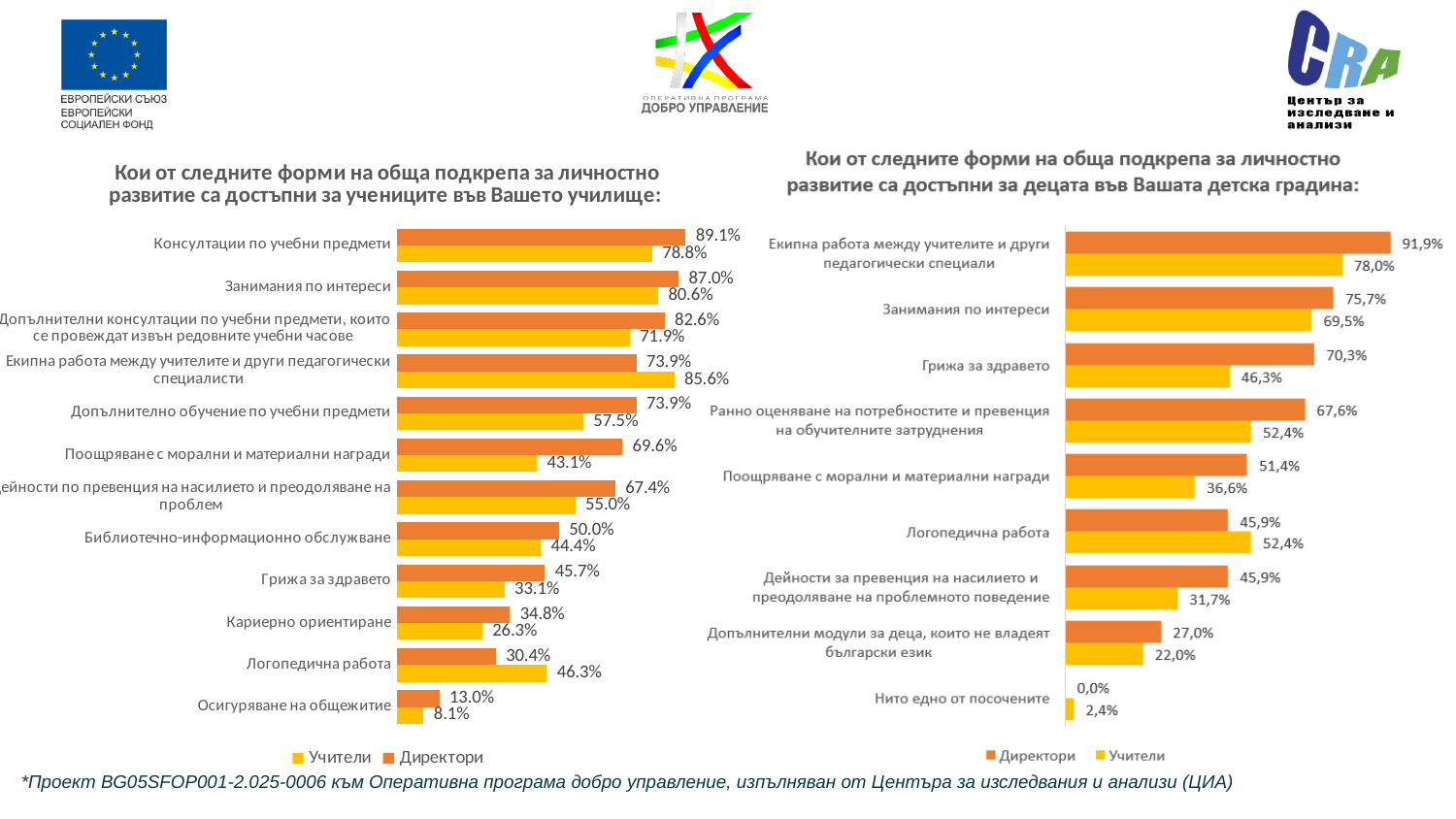
In the left chart (school), which category has the lowest Директори value? Осигуряване на общежитие How many categories does the right chart (kindergarten) show? 9 How many categories does the left chart (school) show? 12 In the right chart (kindergarten), which category has the highest Учители value? Екипна работа между учителите и други педагогически специали In the right chart (kindergarten), what is the value for Директори for 'Грижа за здравето'? 70,3% In the right chart (kindergarten), what is the value for Учители for 'Нито едно от посочените'? 2,4% In the left chart (school), what is the value for Директори for 'Консултации по учебни предмети'? 89.1% In the left chart (school), what is the value for Учители for 'Логопедична работа'? 46.3% In the left chart (school), what is the difference between the Директори and Учители values for 'Поощряване с морални и материални награди'? 26.5% What type of chart is the left chart (school)? Bar chart How many series does the legend of the right chart (kindergarten) list? 2 In the right chart (kindergarten), which is larger for 'Логопедична работа': the Директори value or the Учители value? Учители